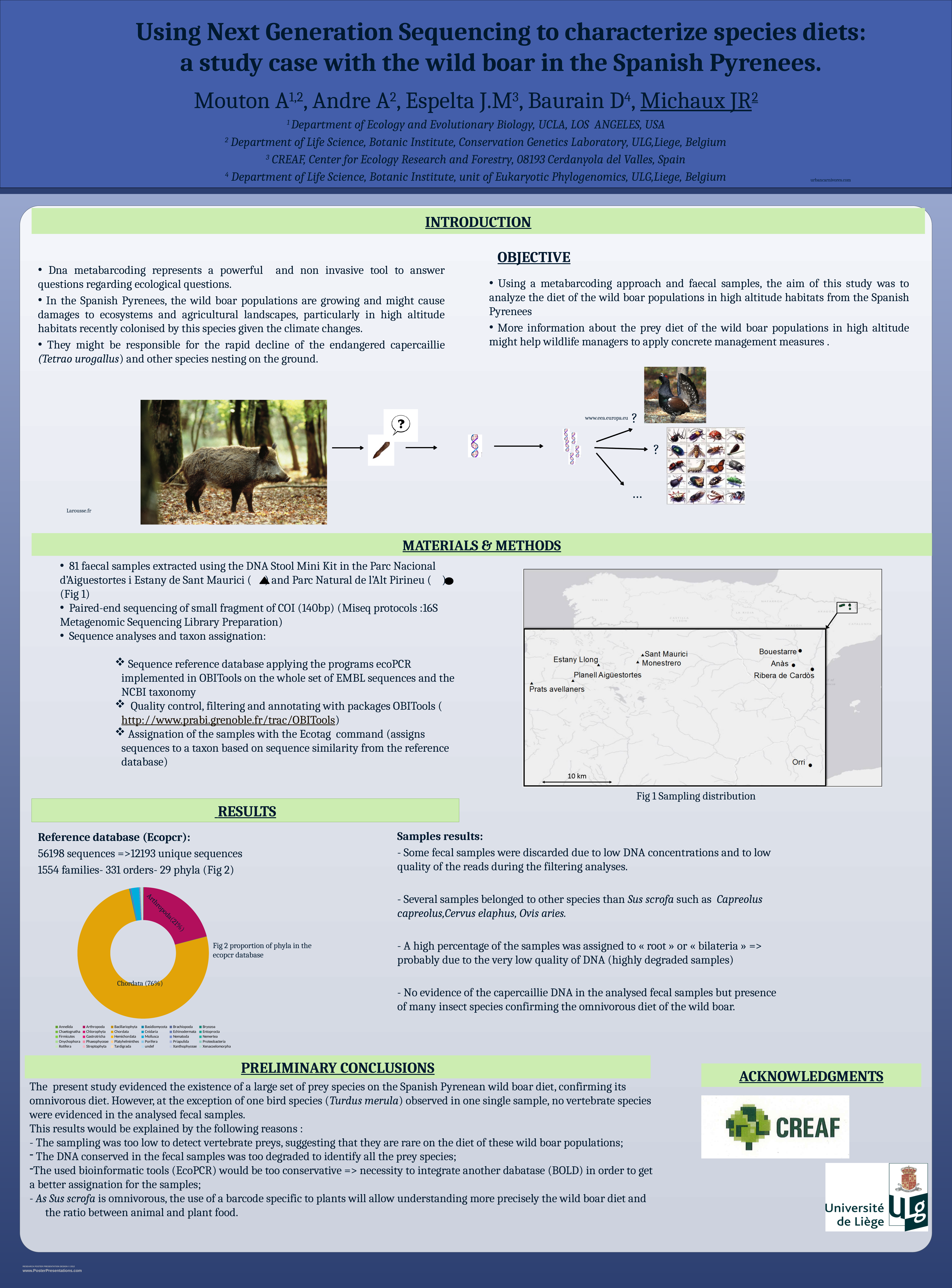
In Fig 2, which slice is larger, Chordata or Arthropoda? Chordata What kind of chart is Fig 2 on the slide? Doughnut (pie) chart What is the caption of the chart in the Results section? Fig 2 proportion of phyla in the ecopcr database In Fig 2, what share of the ecopcr database is Chordata? 76% In Fig 2, what do the Chordata and Arthropoda slices add up to? 97% In Fig 2, which phylum has the largest slice? Chordata In Fig 2, by how many percentage points does the Chordata share exceed the Arthropoda share? 55 percentage points In Fig 2, is the Chordata share greater or less than 50%? greater In Fig 2, what share of the ecopcr database is Arthropoda? 21% In Fig 2, is the Arthropoda share greater or less than 25%? less In Fig 2, what colour is the Chordata slice? Orange